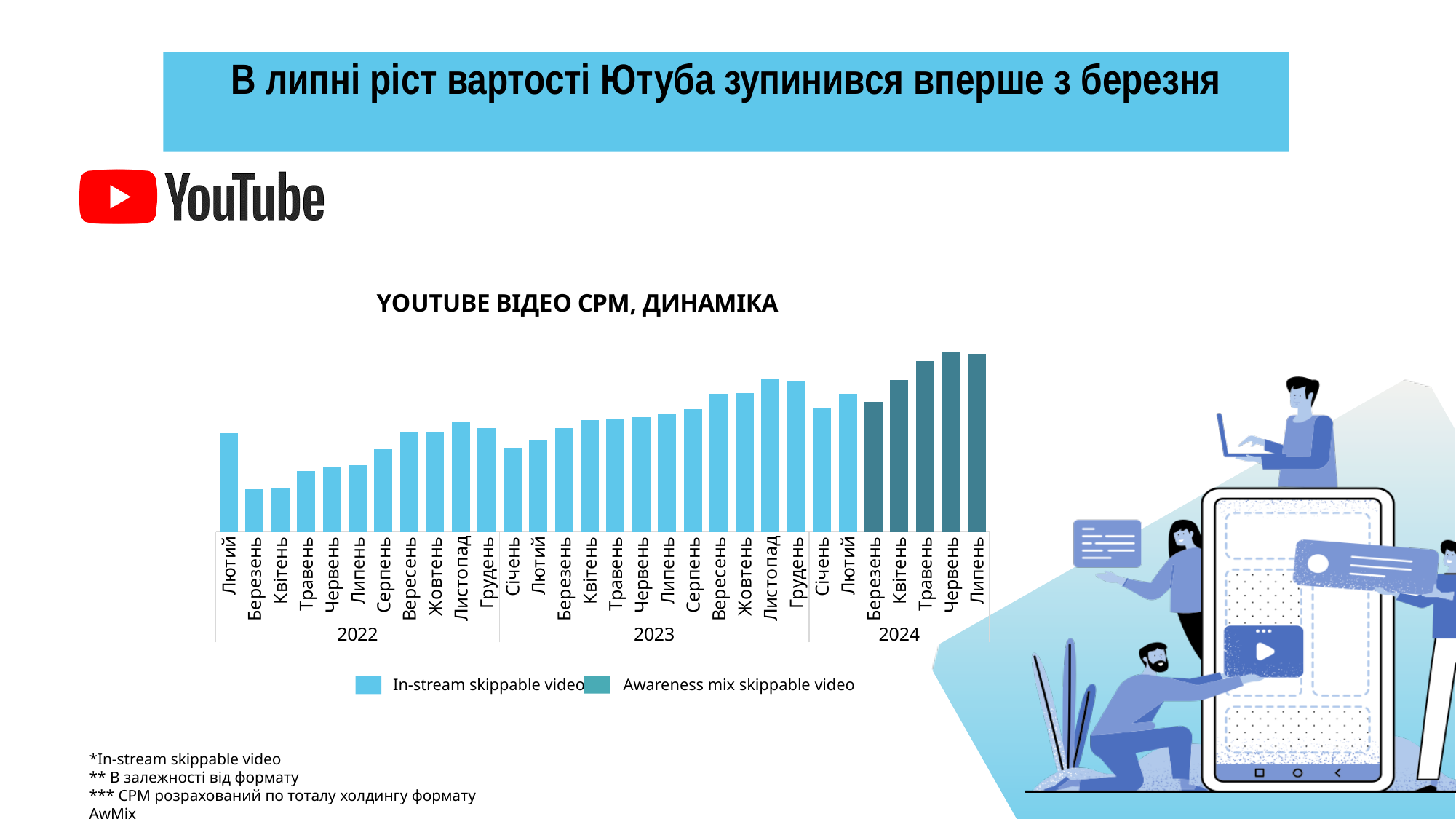
Which is larger in the chart: the bar for Листопад 2023 or the bar for Січень 2024? Листопад 2023 How many monthly bars are plotted for 2024 in the chart? 7 Do the bars generally rise or fall from Березень 2022 to Листопад 2022? Rise What kind of chart is shown under the title "YOUTUBE ВІДЕО CPM, ДИНАМІКА"? Bar chart Which year groups are shown on the x axis of the chart? 2022, 2023, 2024 How many monthly bars are plotted for 2023 in the chart? 12 How many series does the legend of the chart list? 2 What are the two series named in the chart legend? In-stream skippable video; Awareness mix skippable video Which is larger in the chart: the bar for Червень 2024 or the bar for Березень 2024? Червень 2024 Which is larger in the chart: the bar for Лютий 2022 or the bar for Березень 2022? Лютий 2022 Do the bars rise or fall from Березень 2024 to Червень 2024? Rise How many monthly bars are plotted in total across the whole chart? 30